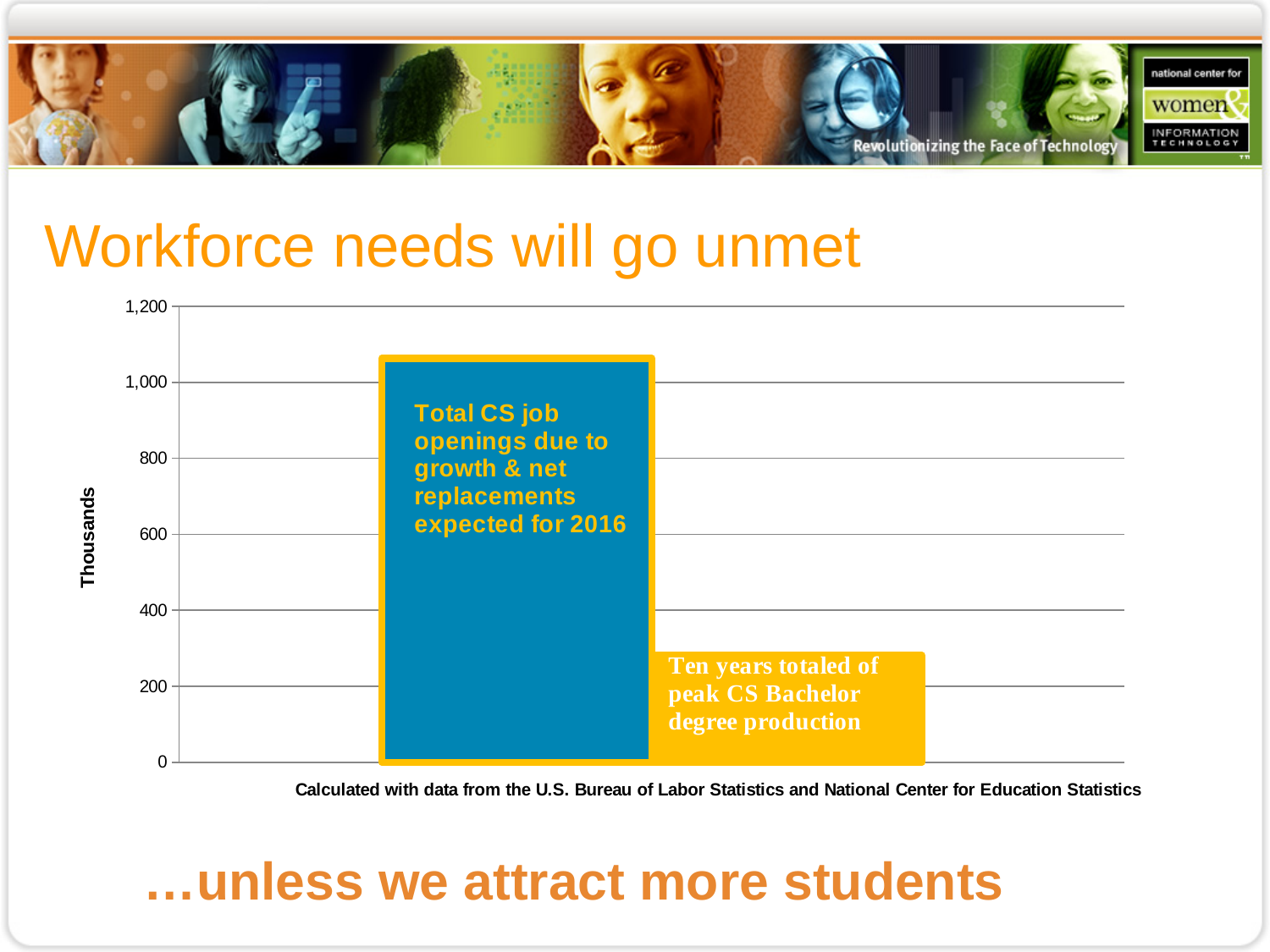
Is the value for total CS job openings expected for 2016 greater or less than 1,000? greater What is the highest tick value shown on the vertical axis? 1,200 Which bar is the tallest in the chart? Total CS job openings due to growth & net replacements expected for 2016 How many bars are plotted in the chart? 2 Which bar is the shortest in the chart? Ten years totaled of peak CS Bachelor degree production What kind of chart is shown on the slide? Bar chart Is the value for total CS job openings expected for 2016 greater or less than 1,200? less Which is larger: total CS job openings expected for 2016 or ten years totaled of peak CS Bachelor degree production? Total CS job openings expected for 2016 Is the value for ten years totaled of peak CS Bachelor degree production greater or less than 400? less What is the label on the vertical axis of the chart? Thousands